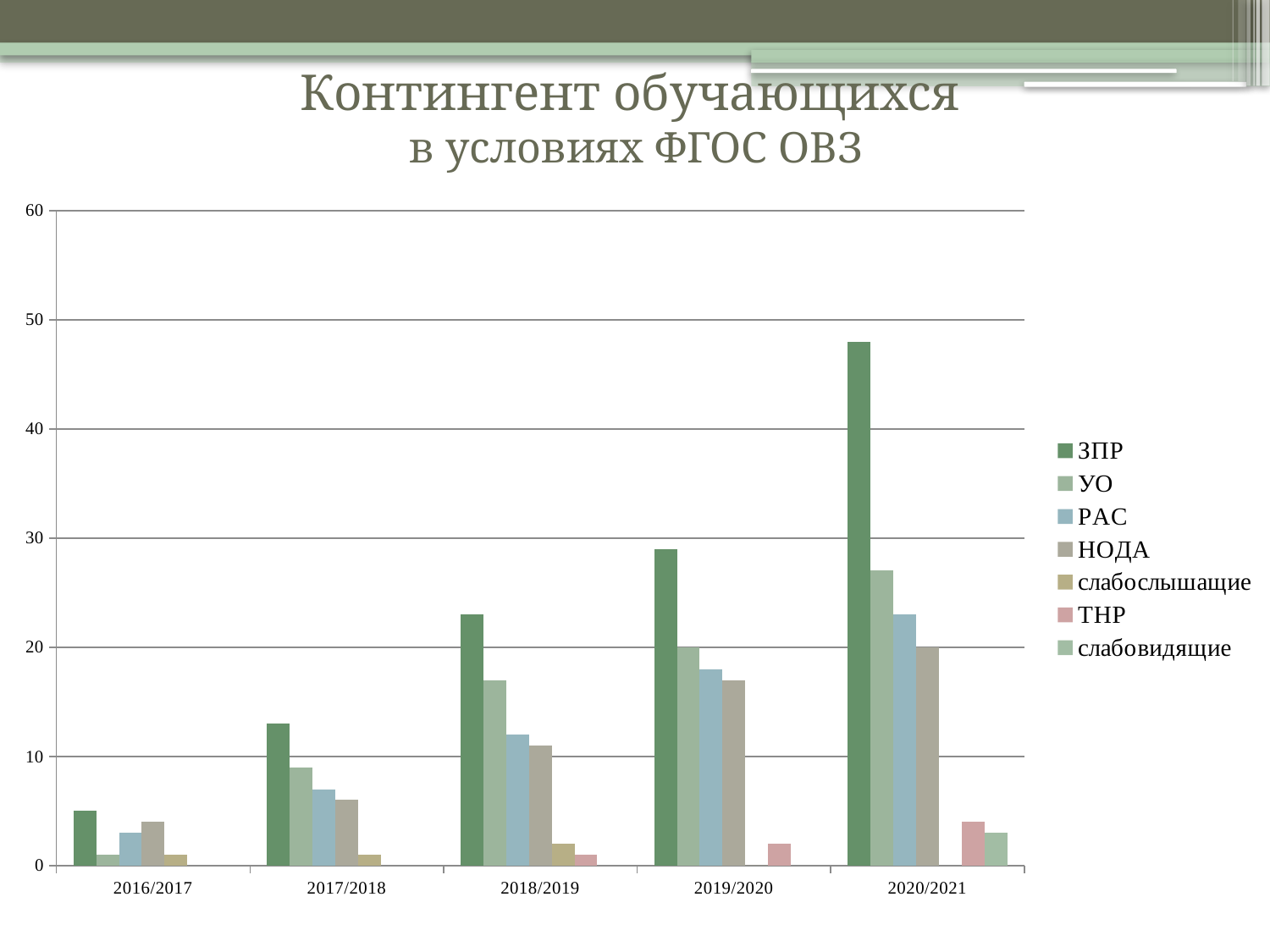
Is the ЗПР value for 2019/2020 greater or less than 30? less What kind of chart is shown on the slide? bar chart Is the ЗПР value for 2020/2021 greater or less than 40? greater How many academic years are shown on the x axis? 5 How many series does the legend list? 7 Is the РАС value for 2018/2019 greater or less than 10? greater Does the ЗПР value rise or fall from 2016/2017 to 2020/2021? rises In which academic year is the ЗПР value lowest? 2016/2017 Which series is shown in the darkest green colour in the legend? ЗПР In which academic year is the ЗПР value highest? 2020/2021 Which is larger in 2020/2021, the ЗПР value or the УО value? ЗПР